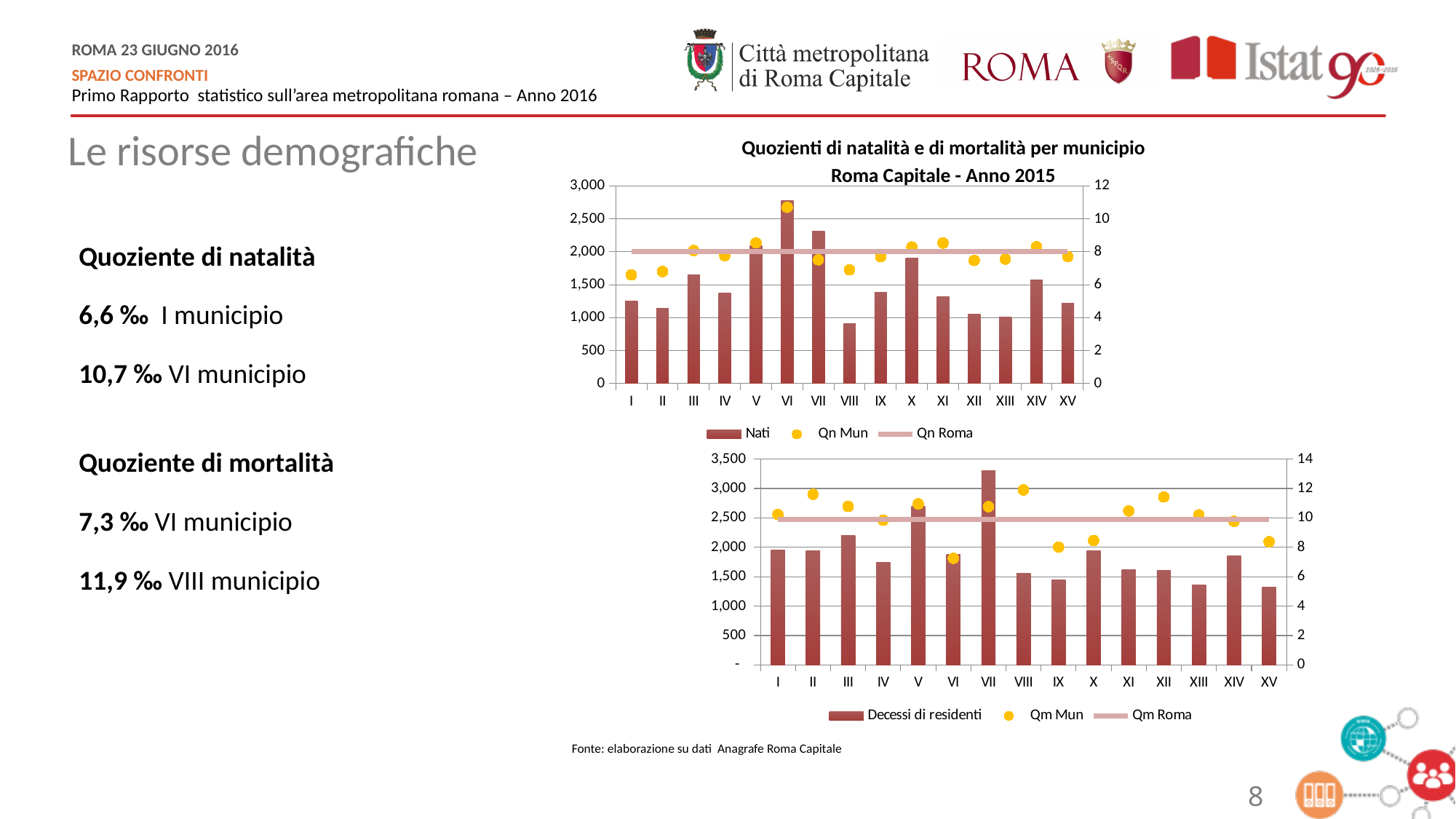
On the top chart, how many series does the legend list? 3 On the bottom chart, which municipio has the highest Qm Mun value? VIII On the top chart, which municipio has the highest number of Nati? VI On the top chart, which municipio has the lowest Qn Mun value? I On the top chart, is the Nati value for municipio VI greater or less than 2,500? greater On the bottom chart, is the Decessi di residenti value for municipio VII greater or less than 3,000? greater On the bottom chart, how many municipi are shown on the x axis? 15 On the top chart, which municipio has the lowest number of Nati? VIII On the bottom chart, which municipio has the lowest Qm Mun value? VI On the bottom chart, which municipio has the highest number of Decessi di residenti? VII On the top chart, is the Nati value for municipio VIII greater or less than 1,000? less